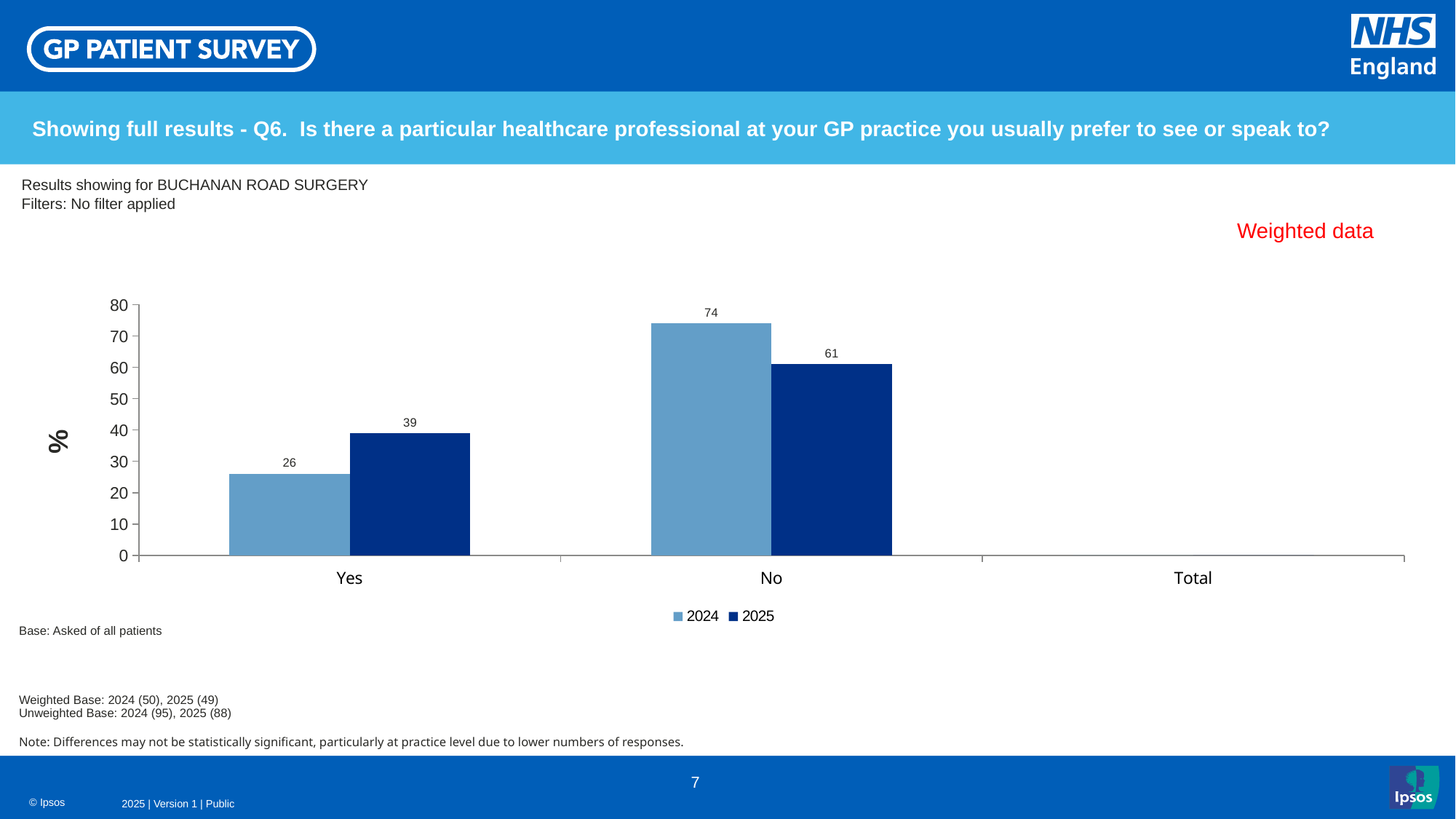
What is the difference between the 2024 and 2025 values for No? 13 What is the difference between the 2025 and 2024 values for Yes? 13 What is the 2024 value for Yes? 26 How many series does the legend list? 2 What is the 2024 value for No? 74 Which category has the lowest 2025 value? Yes What kind of chart is shown on the slide? Bar chart What label is shown on the vertical axis? % What is the 2025 value for No? 61 Which is larger for Yes: the 2024 value or the 2025 value? 2025 What is the 2025 value for Yes? 39 Which category has the highest 2024 value? No